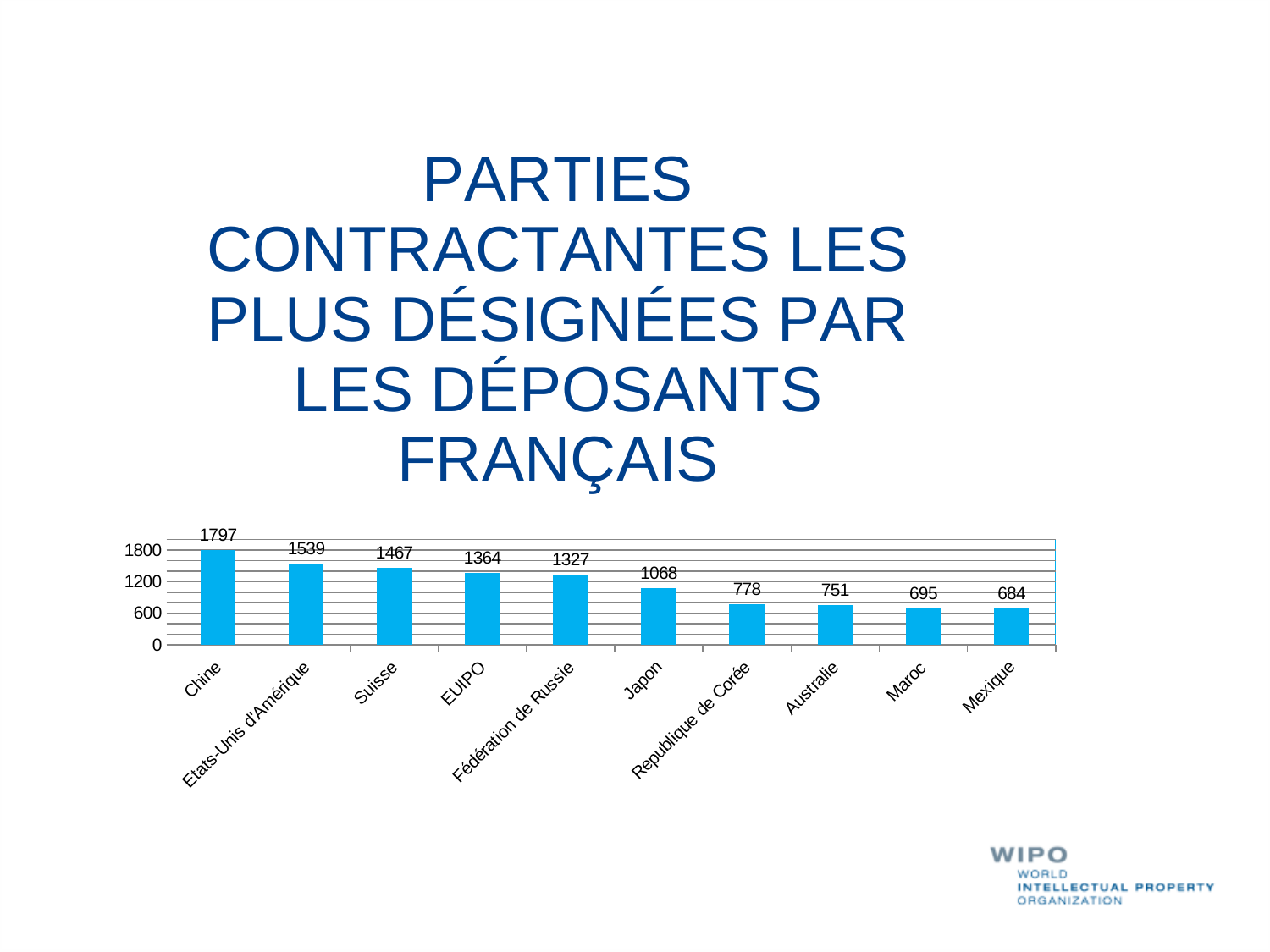
Which category has the lowest value? Mexique What kind of chart is shown on the slide? bar chart Which is larger, the value for Suisse or the value for EUIPO? Suisse What is the value for Maroc? 695 Which category has the highest value? Chine Is the value for Australie greater or less than 1200? less How many categories are shown on the x axis? 10 What is the difference between the values for Chine and Etats-Unis d'Amérique? 258 What is the difference between the values for Japon and Republique de Corée? 290 What is the value for Chine? 1797 Do the values rise or fall from left to right along the x axis? fall What is the value for Fédération de Russie? 1327